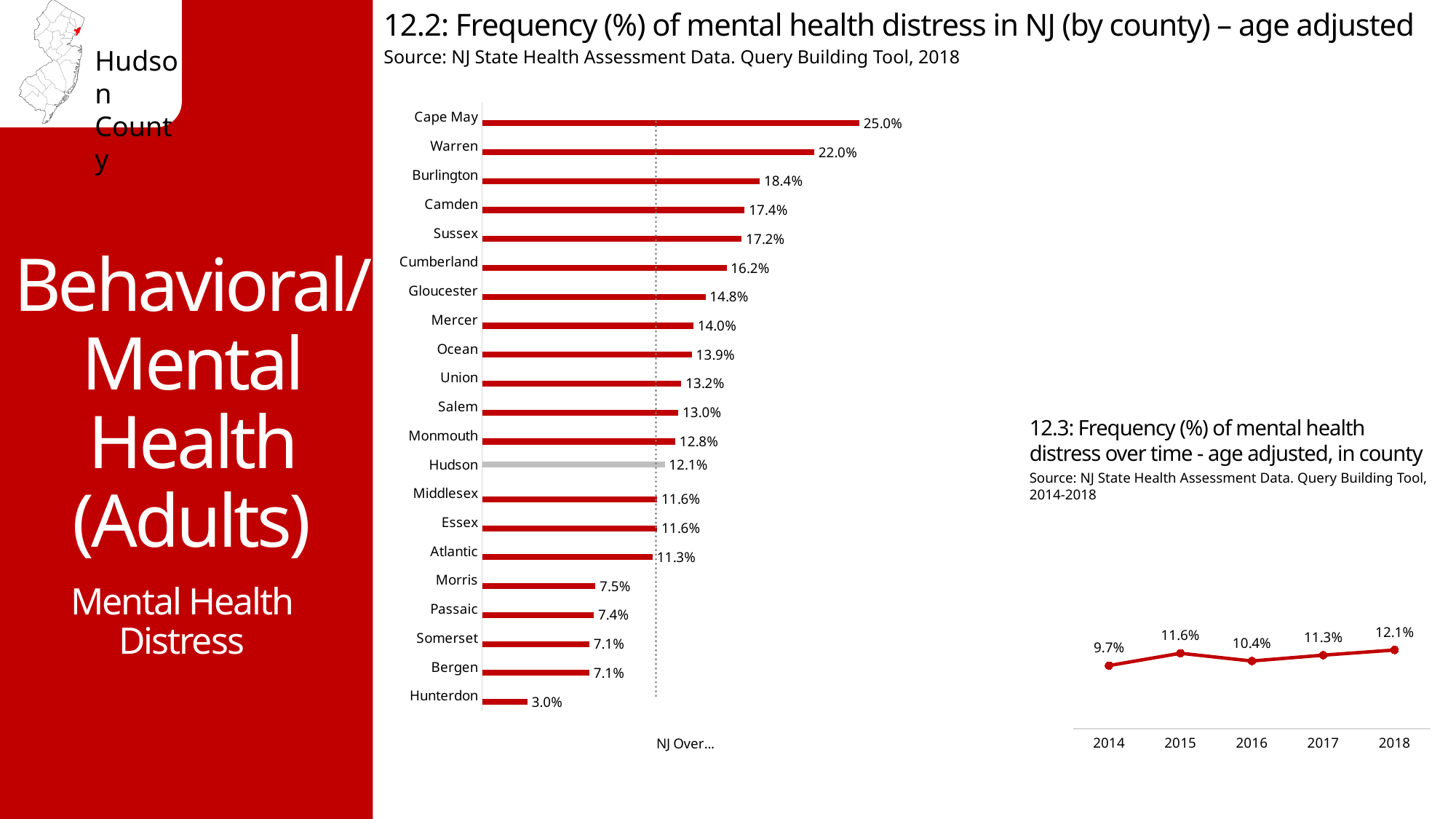
In the chart '12.3: Frequency (%) of mental health distress over time - age adjusted, in county', what is the value for 2016? 10.4% In the chart '12.2: Frequency (%) of mental health distress in NJ (by county) – age adjusted', what is the value for Hudson? 12.1% In the chart '12.2: Frequency (%) of mental health distress in NJ (by county) – age adjusted', which is larger, Camden or Sussex? Camden In the chart '12.3: Frequency (%) of mental health distress over time - age adjusted, in county', which year has the highest value? 2018 In the chart '12.2: Frequency (%) of mental health distress in NJ (by county) – age adjusted', which county has the highest value? Cape May In the chart '12.2: Frequency (%) of mental health distress in NJ (by county) – age adjusted', what is the value for Cumberland? 16.2% What kind of chart is '12.3: Frequency (%) of mental health distress over time - age adjusted, in county'? Line chart In the chart '12.2: Frequency (%) of mental health distress in NJ (by county) – age adjusted', how many counties are shown? 21 In the chart '12.2: Frequency (%) of mental health distress in NJ (by county) – age adjusted', which county has the lowest value? Hunterdon What kind of chart is '12.2: Frequency (%) of mental health distress in NJ (by county) – age adjusted'? Bar chart In the chart '12.2: Frequency (%) of mental health distress in NJ (by county) – age adjusted', what is the difference between Cape May and Warren? 3.0% In the chart '12.3: Frequency (%) of mental health distress over time - age adjusted, in county', what is the difference between 2018 and 2014? 2.4%